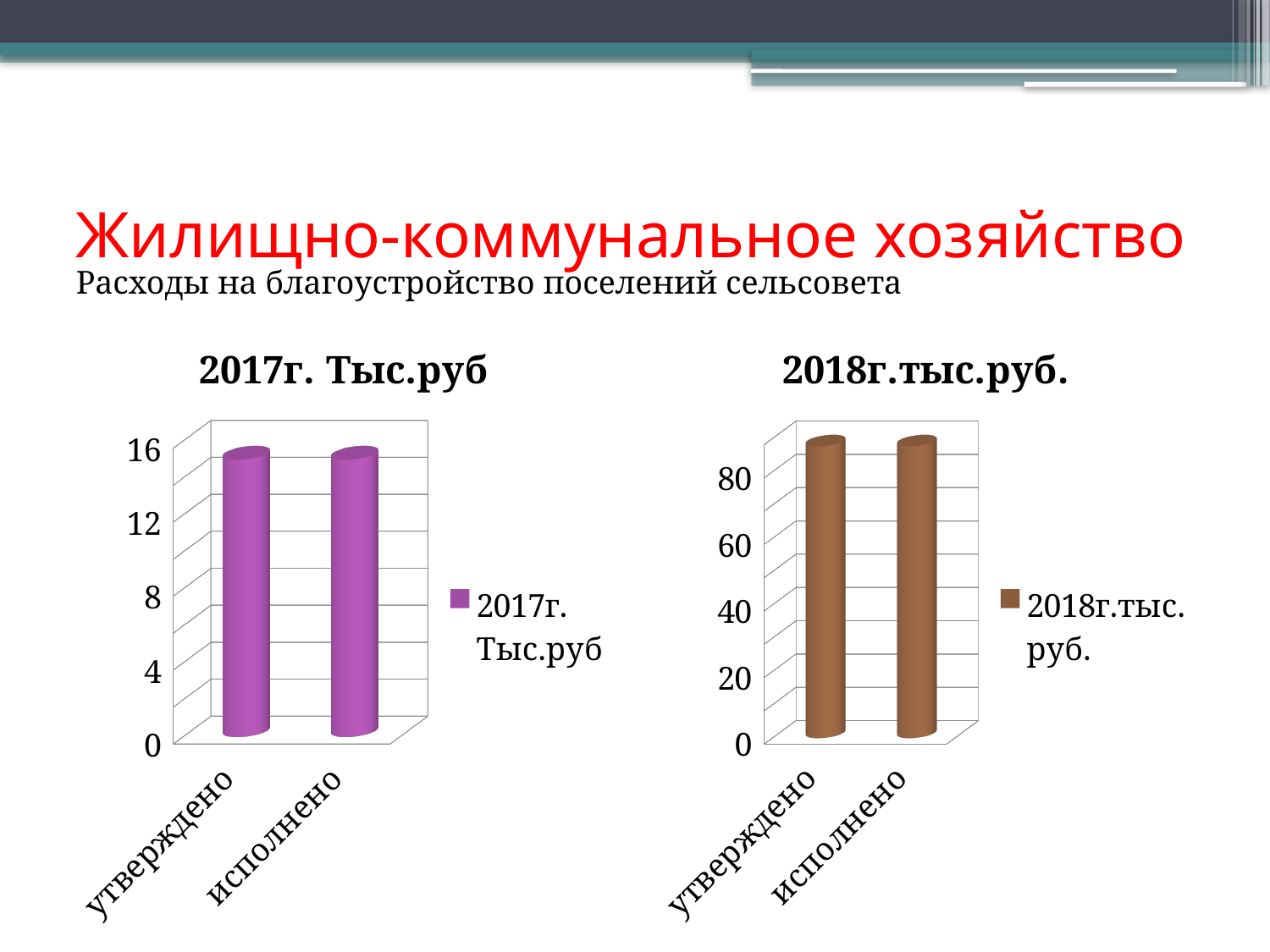
In the '2018г.тыс.руб.' chart, how many bars are plotted? 2 How many series does the legend of the '2018г.тыс.руб.' chart list? 1 What colour are the bars in the '2018г.тыс.руб.' chart? brown How many series does the legend of the '2017г. Тыс.руб' chart list? 1 What kind of chart is the '2018г.тыс.руб.' chart? bar chart In the '2018г.тыс.руб.' chart, is the value for 'исполнено' greater or less than 60? greater In the '2017г. Тыс.руб' chart, is the value for 'утверждено' greater or less than 12? greater In the '2018г.тыс.руб.' chart, is the value for 'утверждено' greater or less than 80? greater What kind of chart is the '2017г. Тыс.руб' chart? bar chart What is the legend entry in the '2017г. Тыс.руб' chart? 2017г. Тыс.руб In the '2017г. Тыс.руб' chart, how many categories are shown on the x axis? 2